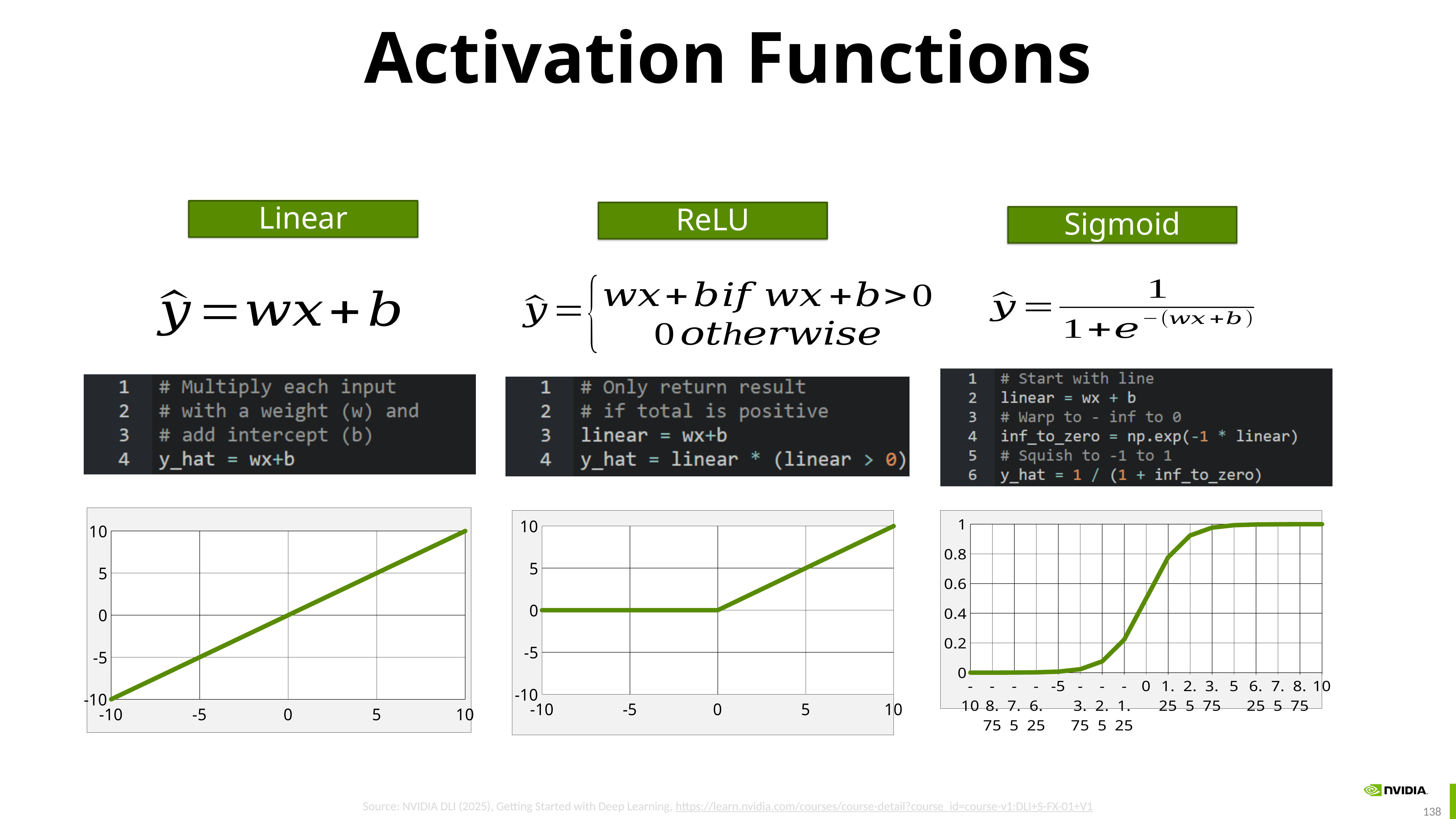
In the Linear chart, do the values rise or fall as x increases? rise In the Linear chart, what is the value of the line at x = -10? -10 In the Linear chart, what is the value of the line at x = 10? 10 In the Sigmoid chart, do the values rise or fall as x increases from -10 to 10? rise What kind of chart is the Sigmoid chart? line chart In the ReLU chart, what is the value of the line at x = 10? 10 In the Sigmoid chart, is the value at x = -5 greater or less than 0.2? less In the ReLU chart, what is the value of the line at x = -5? 0 How many charts are shown on the slide? 3 In the Sigmoid chart, is the value at x = 5 greater or less than 0.8? greater What kind of chart is the Linear chart? line chart In the ReLU chart, is the value at x = 5 greater or less than 0? greater